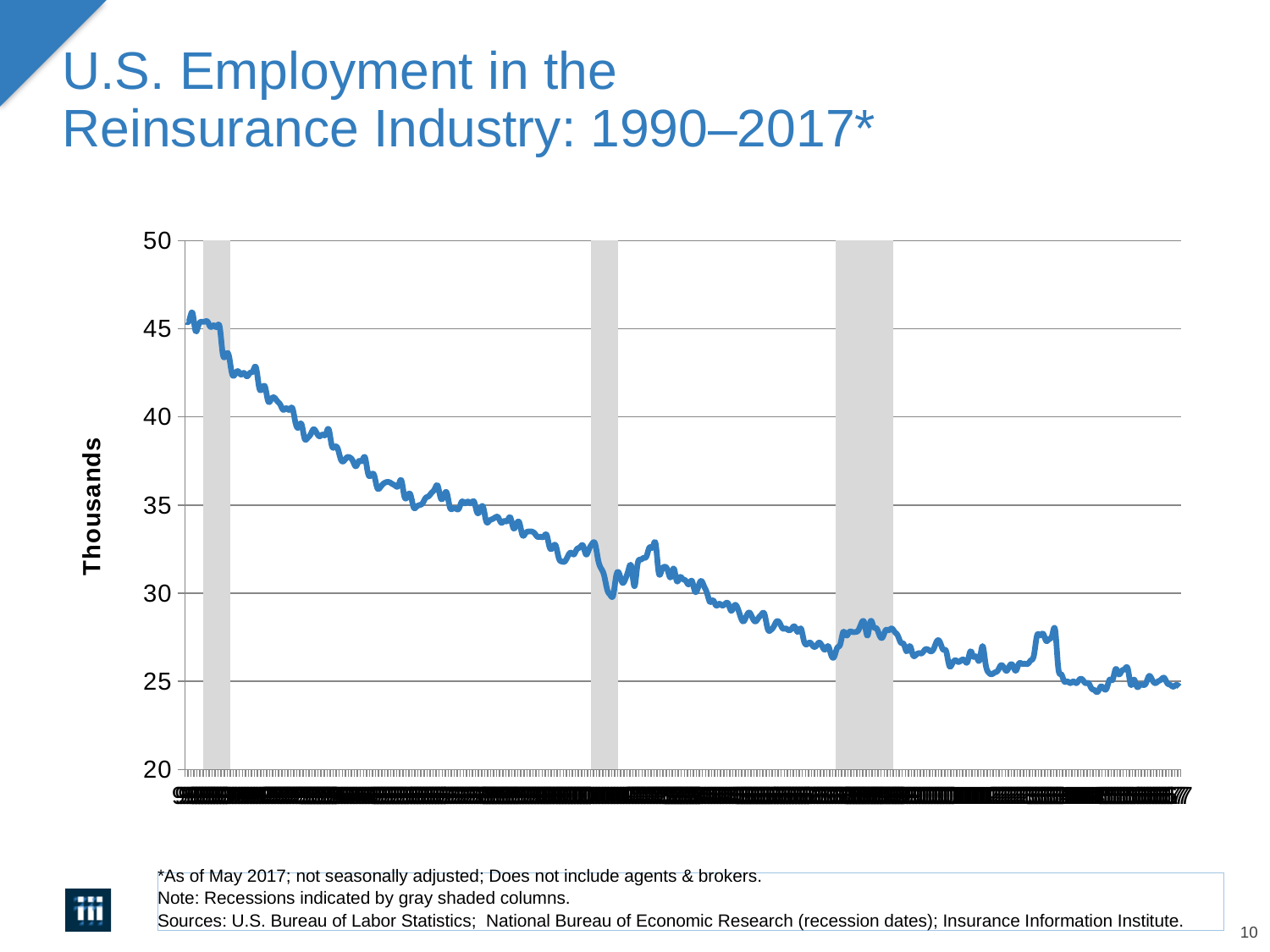
What kind of chart is shown on the slide? line chart Is the value at the end of the series (2017) greater or less than 30? less Do the values generally rise or fall from 1990 to 2017? fall Is the value at the end of the series (2017) greater or less than 35? less What is the label on the vertical axis? Thousands Is the highest value on the line greater or less than 40? greater Is employment higher at the start of the series (1990) or at the end (2017)? at the start (1990) How many gray shaded recession columns are shown on the chart? 3